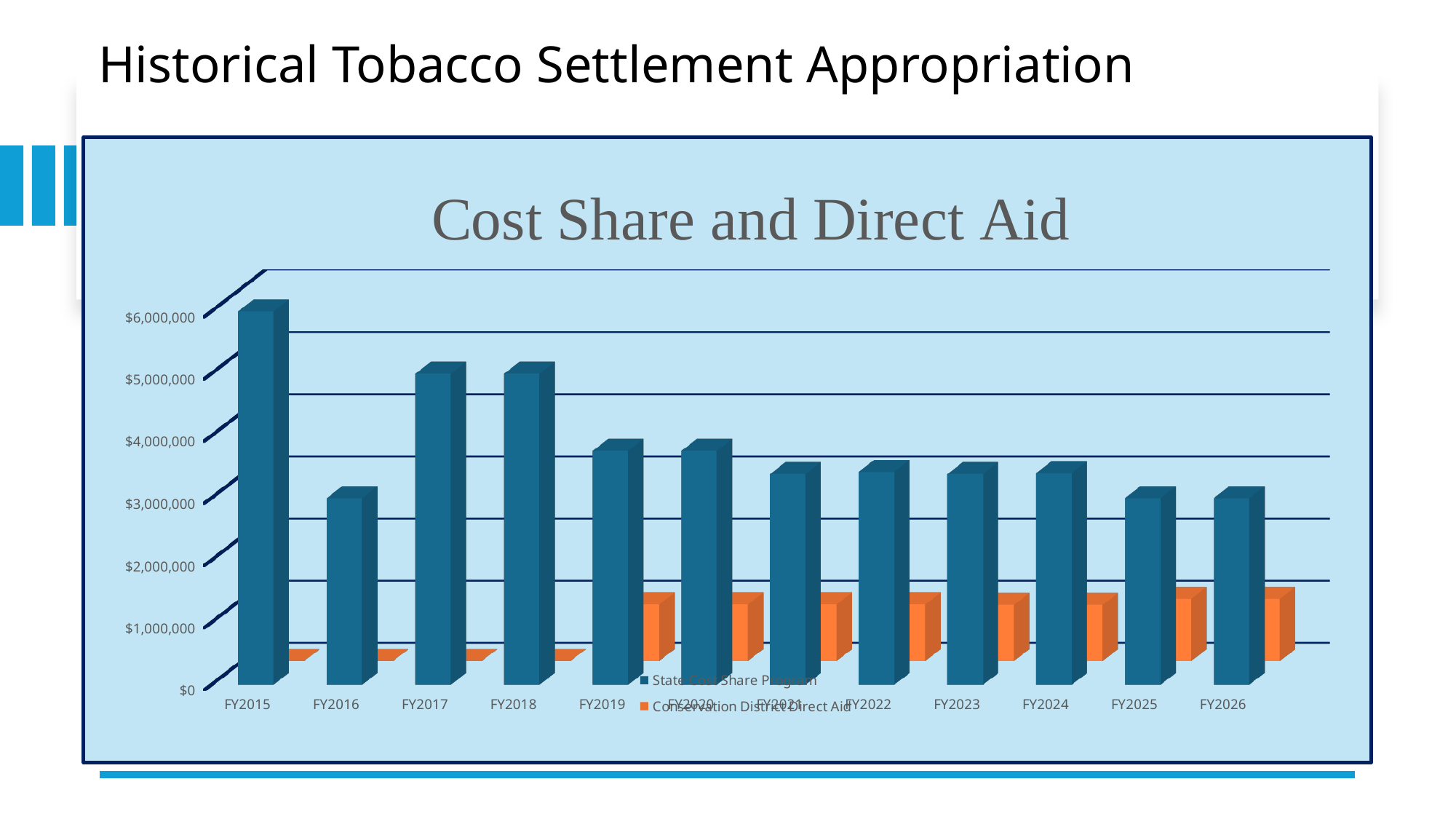
What kind of chart is shown on the slide? bar chart What is the title of the chart? Cost Share and Direct Aid Is the State Cost Share Program value for FY2015 greater or less than $5,000,000? greater How many series does the chart's legend list? 2 Which series is shown in orange in the chart? Conservation District Direct Aid How many fiscal years are shown on the x axis of the chart? 12 Is the State Cost Share Program value for FY2016 greater or less than $4,000,000? less Is the State Cost Share Program value for FY2021 greater or less than $4,000,000? less Which is larger for the State Cost Share Program: FY2017 or FY2019? FY2017 In which fiscal year is the State Cost Share Program value highest? FY2015 Does the Conservation District Direct Aid value rise or fall from FY2018 to FY2019? rise